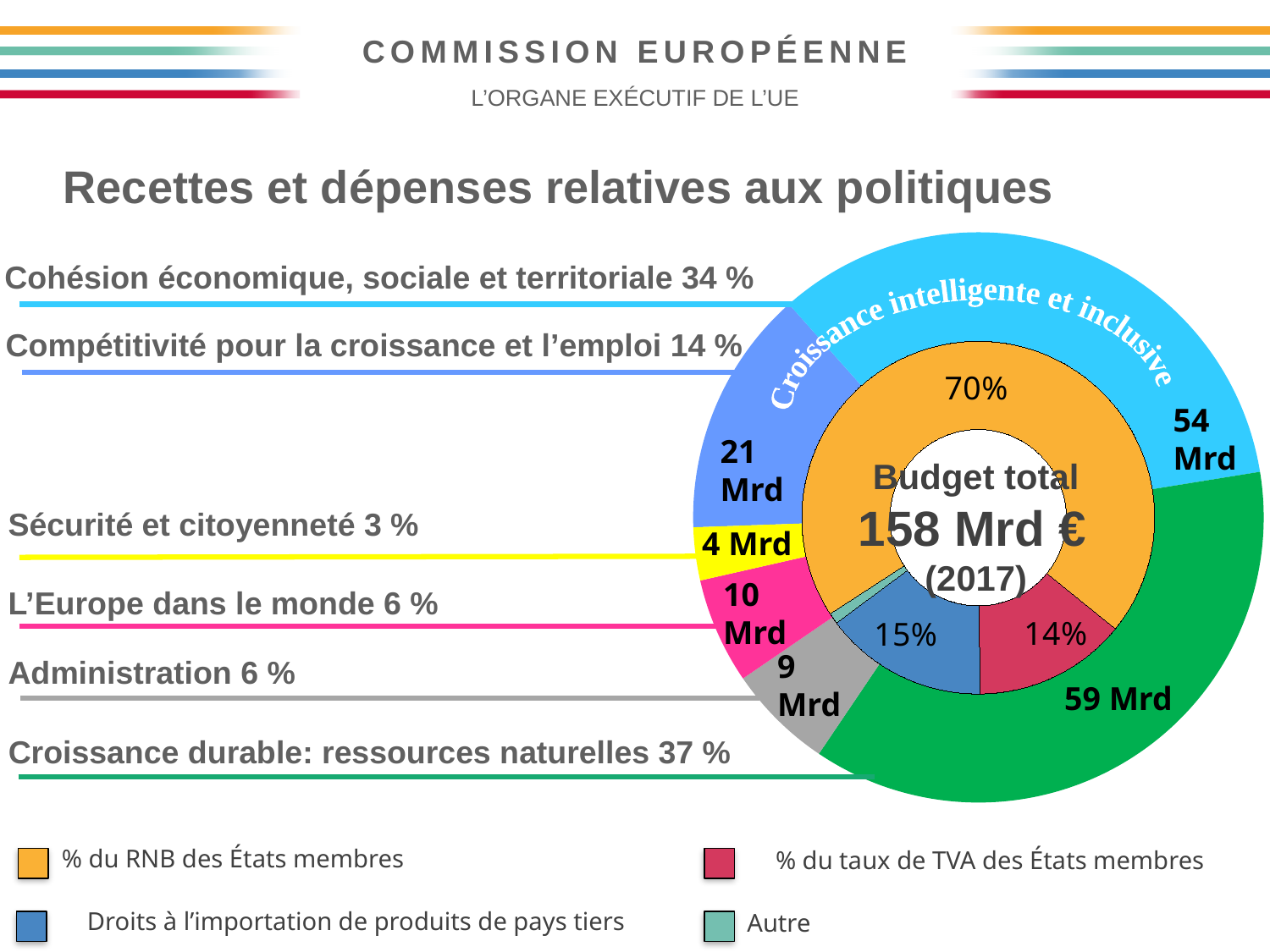
Which is larger: the amount for 'Compétitivité pour la croissance et l'emploi' or for 'L'Europe dans le monde'? Compétitivité pour la croissance et l'emploi What percentage of revenue comes from '% du RNB des États membres' in the inner ring? 70% How many Mrd are allocated to 'Croissance durable: ressources naturelles' in the outer ring? 59 Mrd How many entries does the legend at the bottom of the slide list? 4 Which policy area has the largest amount in the outer ring? Croissance durable: ressources naturelles What is the total budget shown in the centre of the chart? 158 Mrd € What percentage of revenue comes from 'Droits à l'importation de produits de pays tiers'? 15% What percentage of revenue comes from '% du taux de TVA des États membres'? 14% What is the difference in Mrd between 'Croissance durable: ressources naturelles' (59 Mrd) and 'Cohésion économique, sociale et territoriale' (54 Mrd)? 5 Mrd Which policy area has the smallest amount in the outer ring? Sécurité et citoyenneté What year is indicated in the centre of the chart? 2017 What kind of chart is shown on the slide? Donut (pie) chart